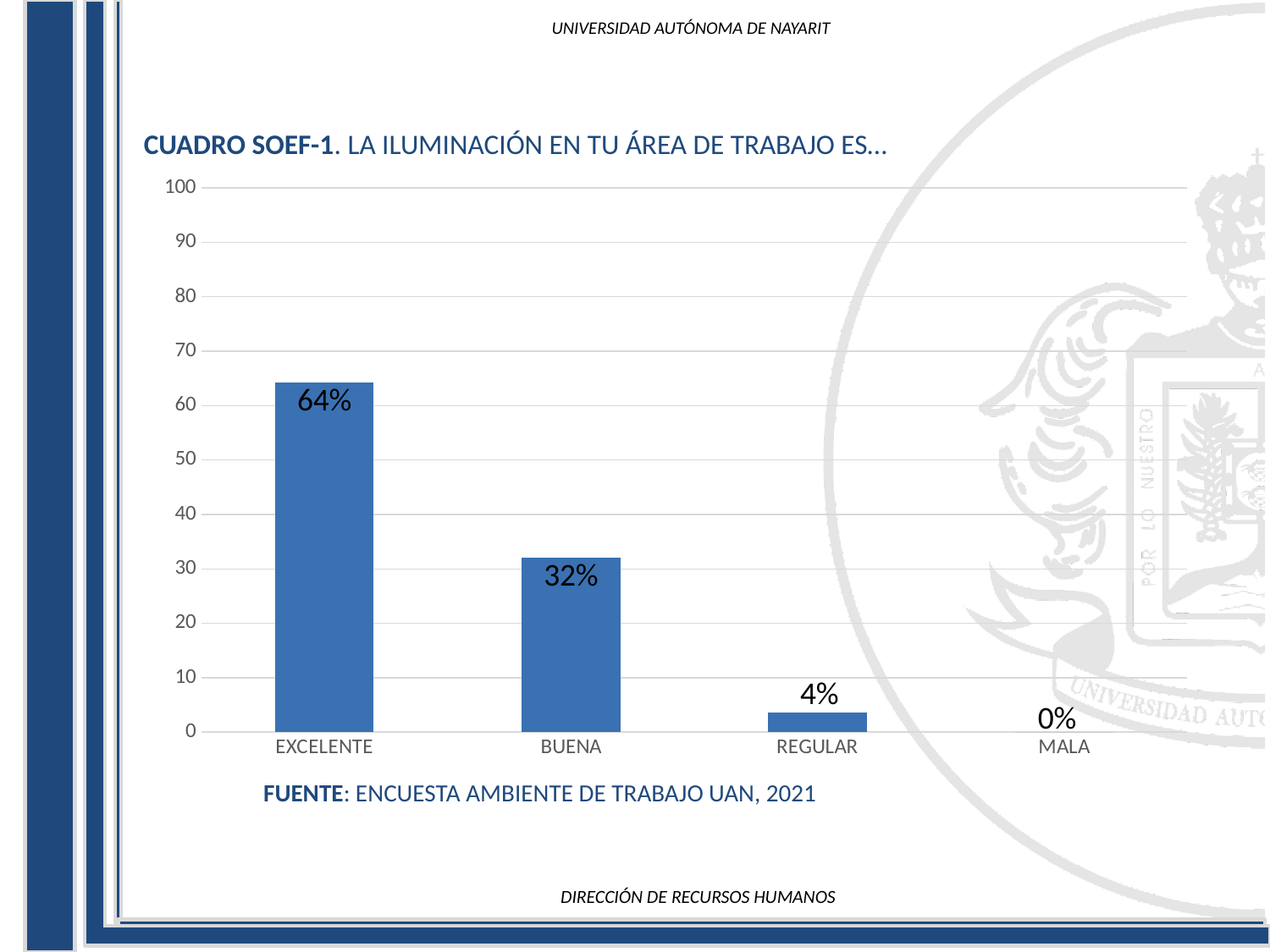
What is the value for EXCELENTE? 64% Is the value for EXCELENTE greater or less than 50? greater What is the value for MALA? 0% What is the source cited below the chart? ENCUESTA AMBIENTE DE TRABAJO UAN, 2021 Which is larger, the value for BUENA or the value for REGULAR? BUENA Which category has the lowest value? MALA What is the difference between the values for EXCELENTE and BUENA? 32% Which category has the highest value? EXCELENTE What is the value for BUENA? 32% How many categories are shown on the x axis? 4 What is the value for REGULAR? 4% What kind of chart is shown on the slide? bar chart